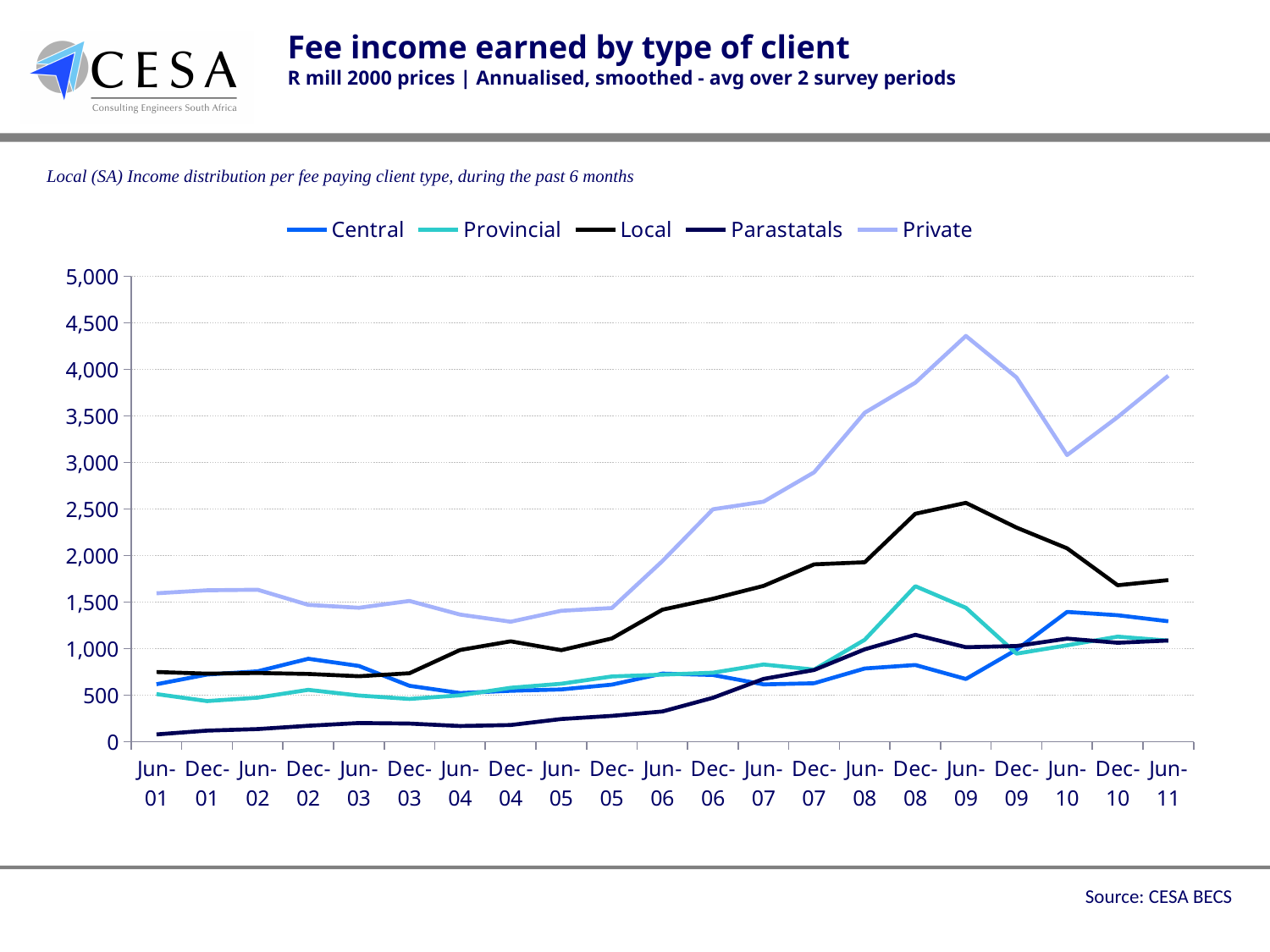
At Jun-11, which is larger: the value for Local or the value for Central? Local Which client type has the lowest fee income at Jun-01? Parastatals Is the value for Local at Jun-09 greater or less than 2,000? greater Is the value for Private at Jun-09 greater or less than 4,000? greater Which client type has the highest fee income at Jun-11? Private How many time points are labelled along the x axis? 21 Is the value for Parastatals at Jun-01 greater or less than 500? less How many series does the legend list? 5 What is the title of the chart on the slide? Fee income earned by type of client Does the Private series rise or fall between Jun-06 and Jun-09? Rise What kind of chart is shown on the slide? Line chart